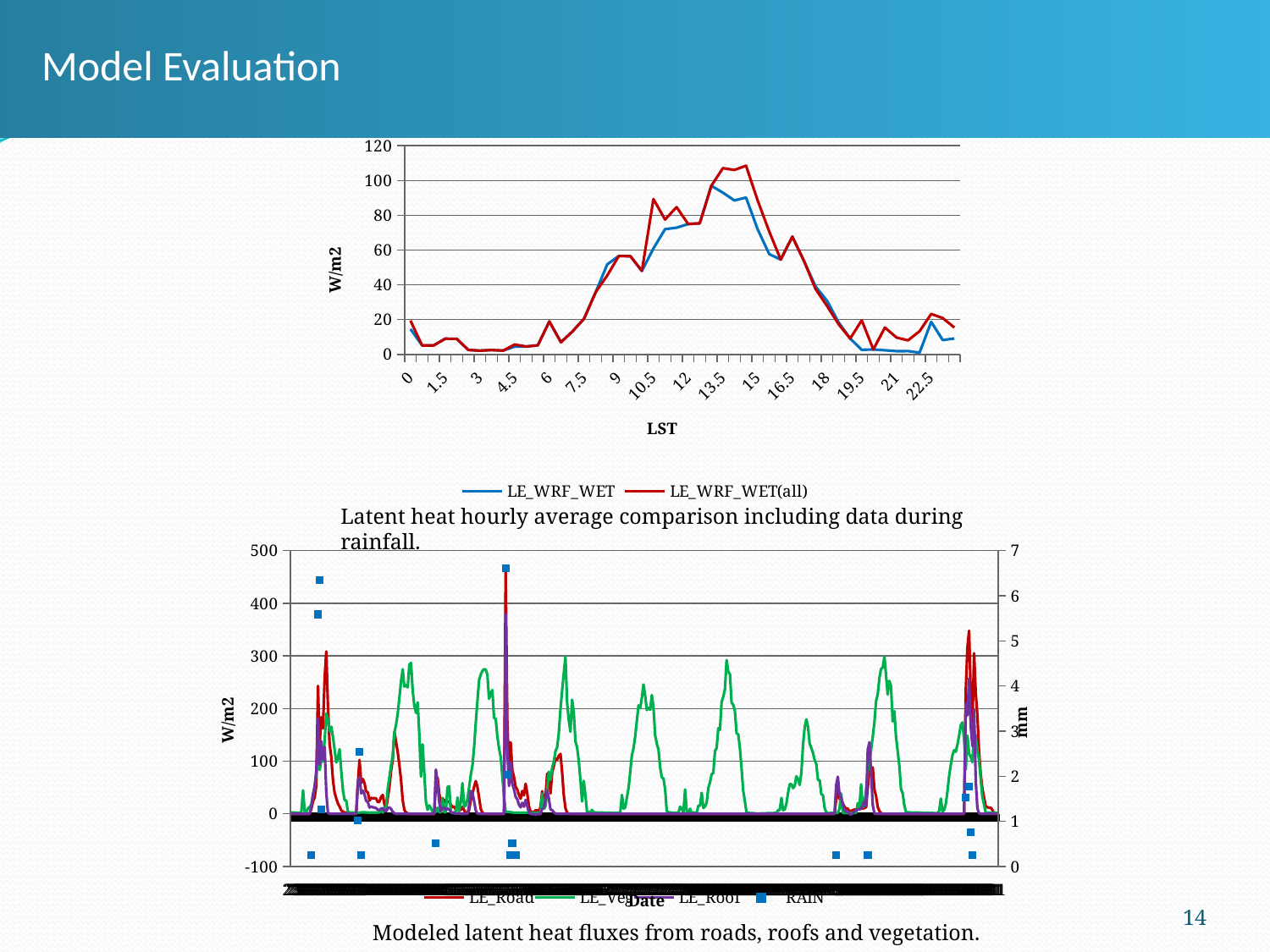
In the bottom chart, is the highest RAIN value greater or less than 6 mm? greater What is the label of the x axis of the top chart? LST In the top chart, is the peak value of LE_WRF_WET(all) greater or less than 100? greater In the top chart, is the value of LE_WRF_WET at LST 3 greater or less than 20? less What kind of chart is the top chart on the slide? line chart In the top chart, do the values rise or fall along the x axis between LST 7.5 and LST 13.5? rise In the top chart, which series reaches the higher peak value, LE_WRF_WET or LE_WRF_WET(all)? LE_WRF_WET(all) In the top chart, do the values rise or fall along the x axis between LST 15 and LST 19.5? fall How many series does the legend of the top chart list? 2 How many series does the legend of the bottom chart list? 4